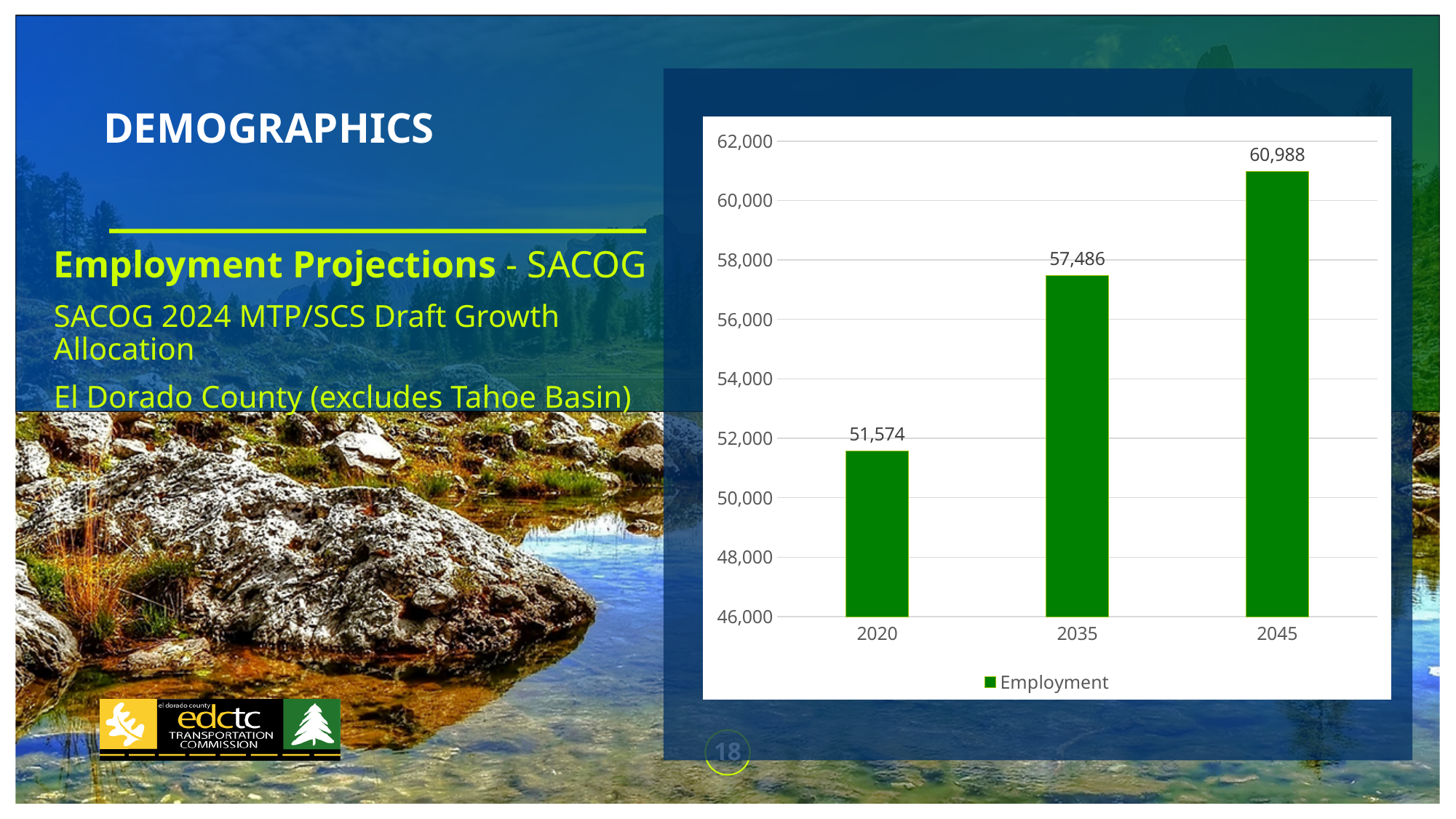
What is the Employment value for 2045? 60,988 Which year has a larger Employment value, 2035 or 2045? 2045 Is the Employment value for 2035 greater or less than 56,000? greater What kind of chart is shown on the slide? Bar chart Which year has the highest Employment value? 2045 What is the difference in Employment between 2035 and 2020? 5,912 What is the difference in Employment between 2045 and 2020? 9,414 What is the Employment value for 2035? 57,486 What is the Employment value for 2020? 51,574 Which year has the lowest Employment value? 2020 How many years are shown on the x axis of the chart? 3 Do the Employment values rise or fall from 2020 to 2045? Rise